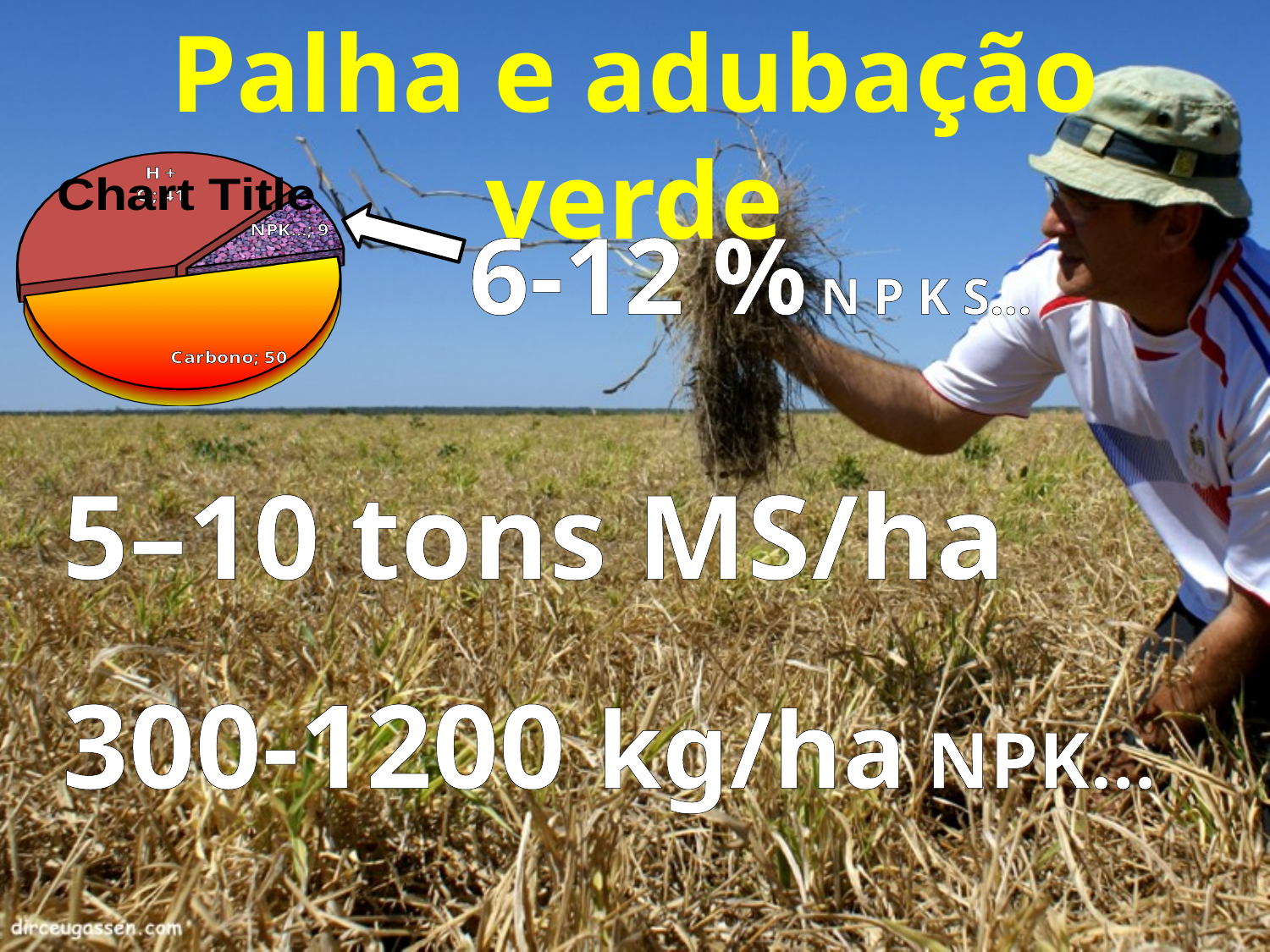
What kind of chart is shown on the slide? pie chart What share of the pie does the Carbono slice represent? 50% What is the difference between the Carbono value and the NPK... value in the pie chart? 41 Which slice of the pie chart is the largest? Carbono Which is larger in the pie chart, Carbono or NPK...? Carbono What is the value of the Carbono slice in the pie chart? 50 What is the value of the NPK... slice in the pie chart? 9 How many slices does the pie chart have? 3 Which slice of the pie chart is the smallest? NPK... What is the title of the pie chart? Chart Title